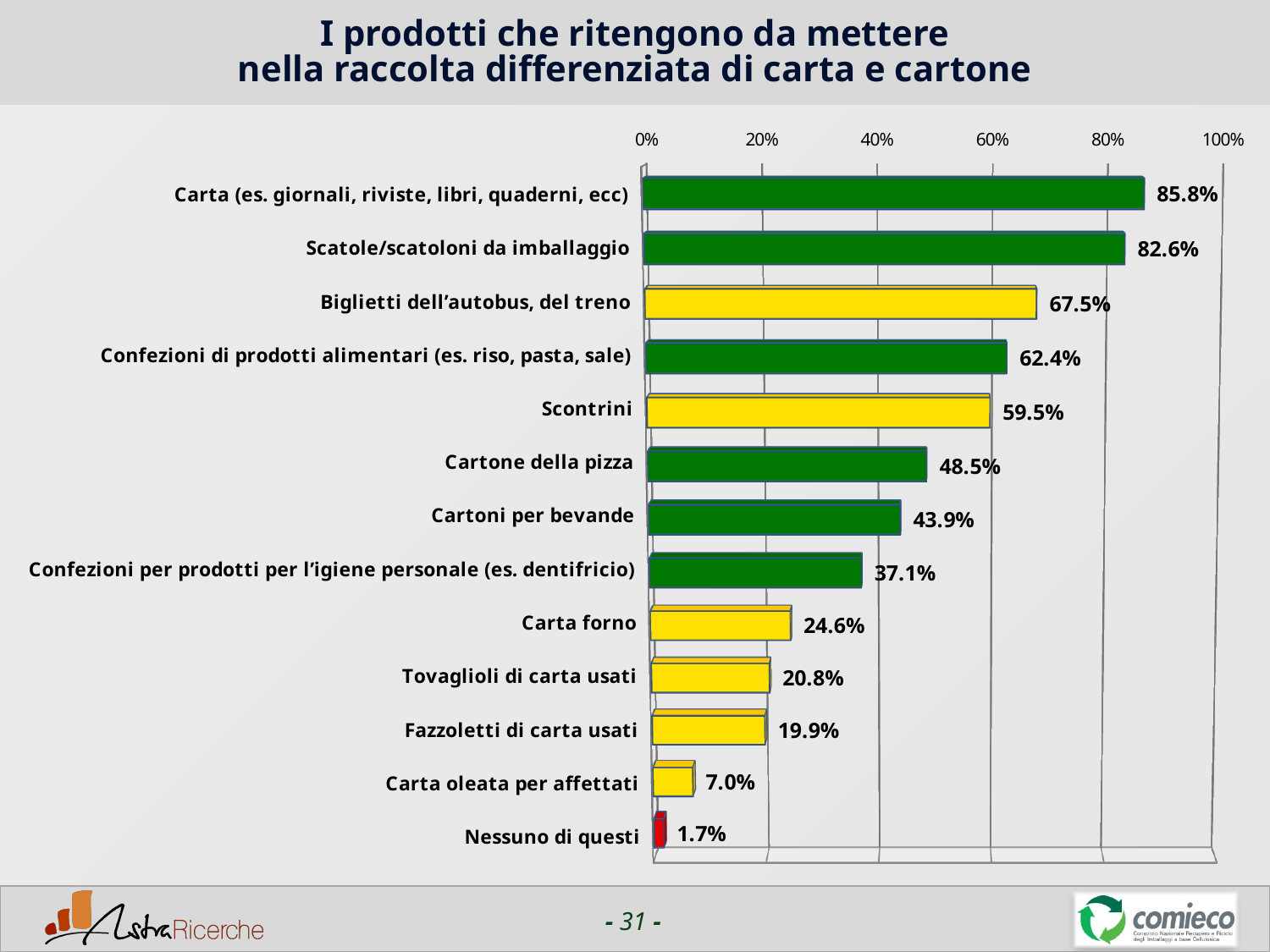
Which is larger, the value for Cartoni per bevande or the value for Confezioni per prodotti per l'igiene personale (es. dentifricio)? Cartoni per bevande Which category has the highest value? Carta (es. giornali, riviste, libri, quaderni, ecc) What is the difference between the values for Biglietti dell'autobus, del treno and Carta forno? 42.9% What colour is the bar for Nessuno di questi? red What is the difference between the values for Carta (es. giornali, riviste, libri, quaderni, ecc) and Scatole/scatoloni da imballaggio? 3.2% What kind of chart is shown on the slide? bar chart Which category has the lowest value? Nessuno di questi What is the value for Cartone della pizza? 48.5% What is the value for Carta oleata per affettati? 7.0% What is the value for Scontrini? 59.5% Is the value for Confezioni di prodotti alimentari (es. riso, pasta, sale) greater or less than 60%? greater How many categories are shown in the chart? 13